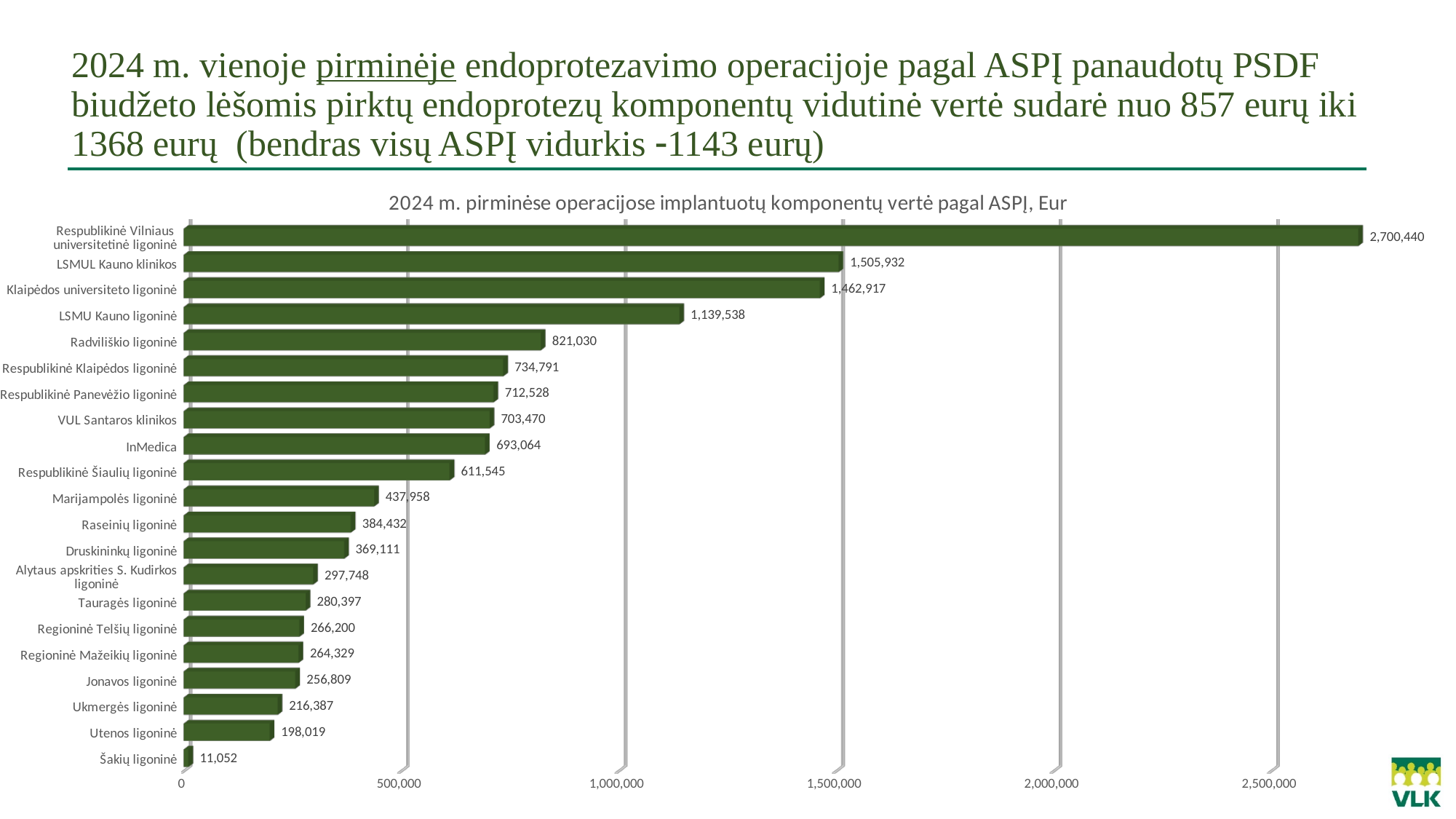
What is the value for Radviliškio ligoninė? 821,030 What is the title of the chart? 2024 m. pirminėse operacijose implantuotų komponentų vertė pagal ASPĮ, Eur What is the value for Druskininkų ligoninė? 369,111 What is the difference between Radviliškio ligoninė and Respublikinė Klaipėdos ligoninė? 86,239 Which hospital has the lowest value? Šakių ligoninė What kind of chart is shown on the slide? bar chart Which is larger, the value for Marijampolės ligoninė or Raseinių ligoninė? Marijampolės ligoninė What is the value for LSMUL Kauno klinikos? 1,505,932 How many hospitals are shown in the chart? 21 Is the value for LSMU Kauno ligoninė greater or less than 1,000,000? greater Which hospital has the highest value? Respublikinė Vilniaus universitetinė ligoninė What is the difference between Respublikinė Vilniaus universitetinė ligoninė and LSMUL Kauno klinikos? 1,194,508